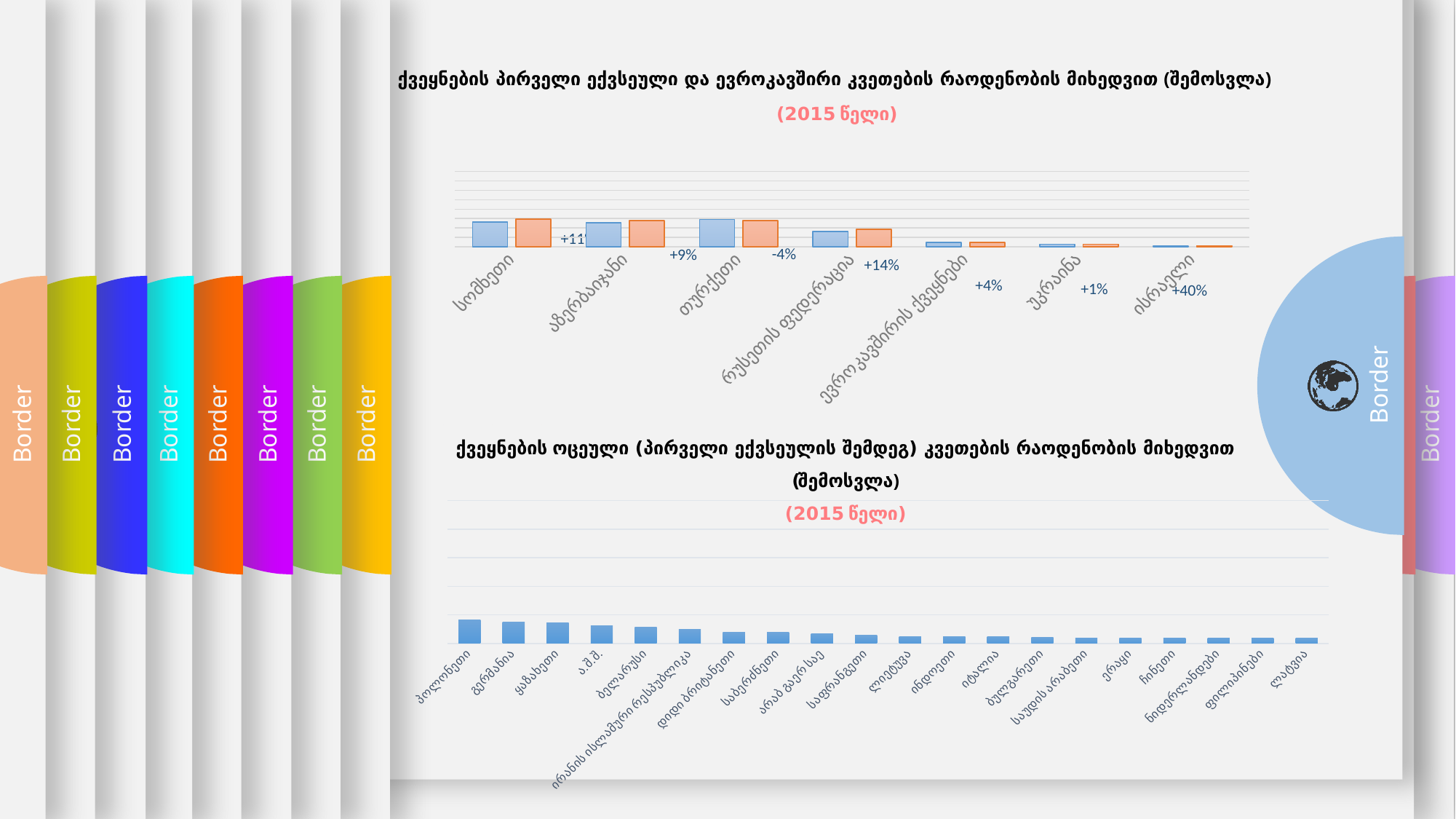
In the top chart, which category has the smallest bars? ისრაელი What kind of chart is the top chart on the slide? bar chart In the top chart, what percentage change is printed for რუსეთის ფედერაცია? +14% In the top chart, how many countries/categories are shown on the x axis? 7 In the top chart, what percentage change is printed for უკრაინა? +1% In the bottom chart, which country has the tallest bar? პოლონეთი In the top chart, how many data series (bar colours) are plotted for each category? 2 In the bottom chart, do the bar values rise or fall from left to right along the x axis? fall In the top chart, what percentage change is printed for თურქეთი? -4% What kind of chart is the bottom chart on the slide? bar chart In the top chart, what percentage change is printed for ისრაელი? +40% In the bottom chart, how many countries are shown on the x axis? 20